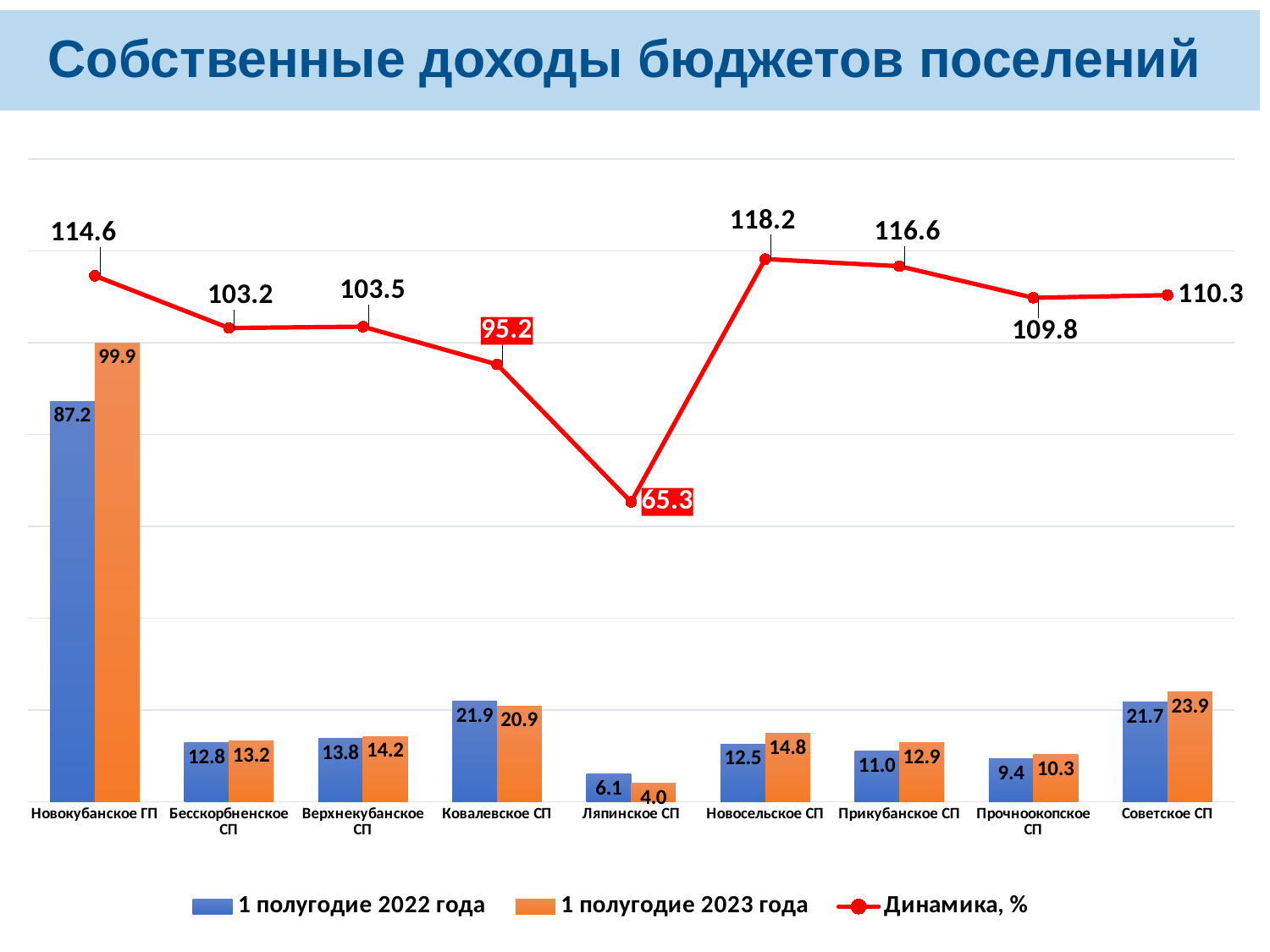
What is the Динамика, % value for Ляпинское СП? 65.3 What kind of chart is shown on the slide? Combined bar and line chart Which is larger for Ковалевское СП: the 1 полугодие 2022 года value or the 1 полугодие 2023 года value? 1 полугодие 2022 года How many categories are shown on the x axis? 9 What is the value for Новокубанское ГП in the series 1 полугодие 2023 года? 99.9 What is the title of the slide? Собственные доходы бюджетов поселений What colour is the Динамика, % line? Red How many series does the legend list? 3 Which category has the lowest value in the series 1 полугодие 2023 года? Ляпинское СП Which category has the highest Динамика, % value? Новосельское СП What is the difference between the 1 полугодие 2023 года and 1 полугодие 2022 года values for Новокубанское ГП? 12.7 What is the value for Советское СП in the series 1 полугодие 2022 года? 21.7